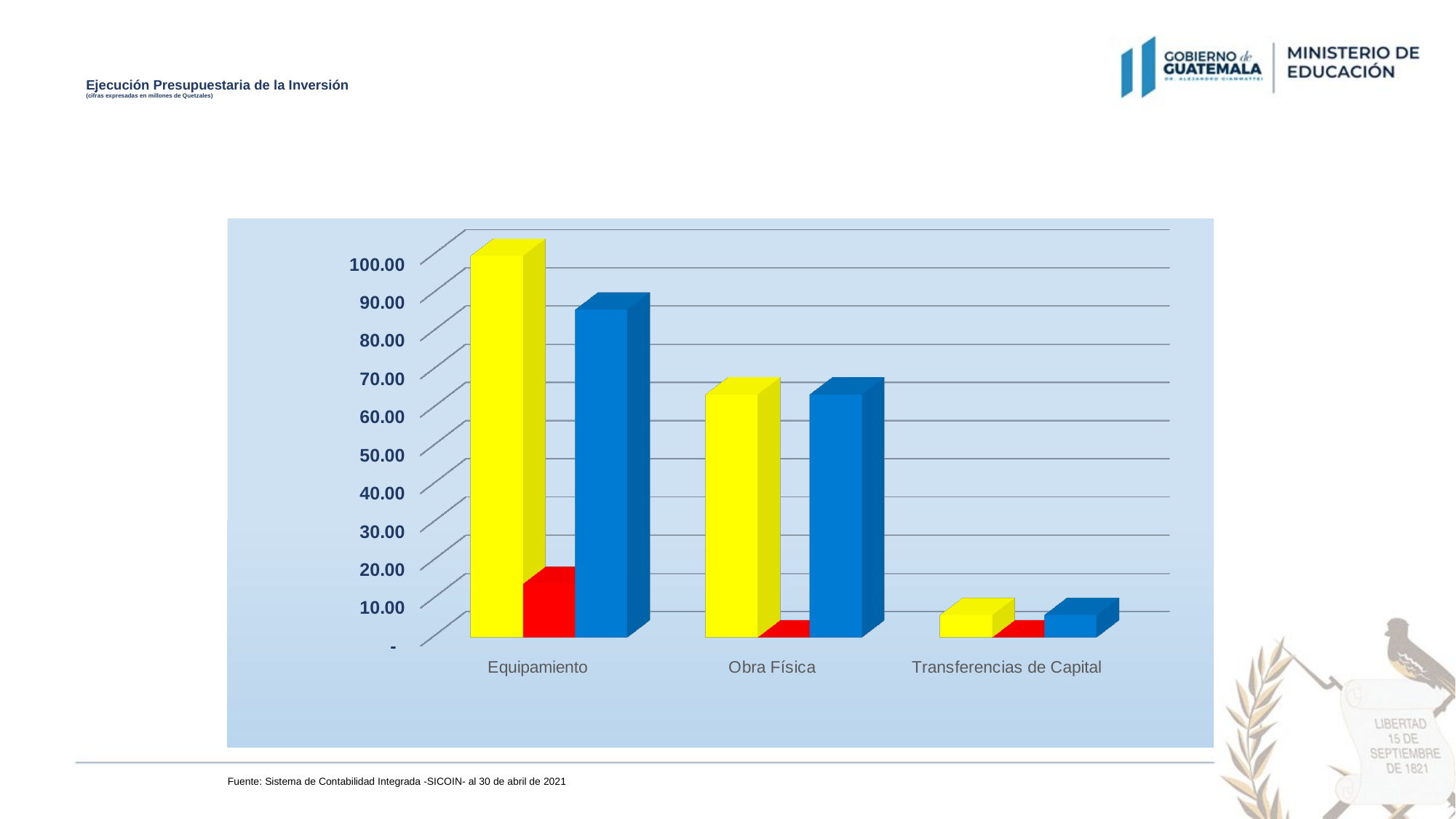
Which is larger, the red bar for Equipamiento or the red bar for Obra Física? The red bar for Equipamiento Is the red bar for Equipamiento greater or less than 30.00? less What kind of chart is shown on the slide? Bar chart Which category has the shortest blue bar? Transferencias de Capital Is the yellow bar for Obra Física greater or less than 50.00? greater How many categories are shown on the x axis of the chart? 3 Which category has the tallest yellow bar? Equipamiento Is the blue bar for Obra Física greater or less than 70.00? less What is the title of the chart on the slide? Ejecución Presupuestaria de la Inversión For Equipamiento, which is larger, the yellow bar or the blue bar? The yellow bar